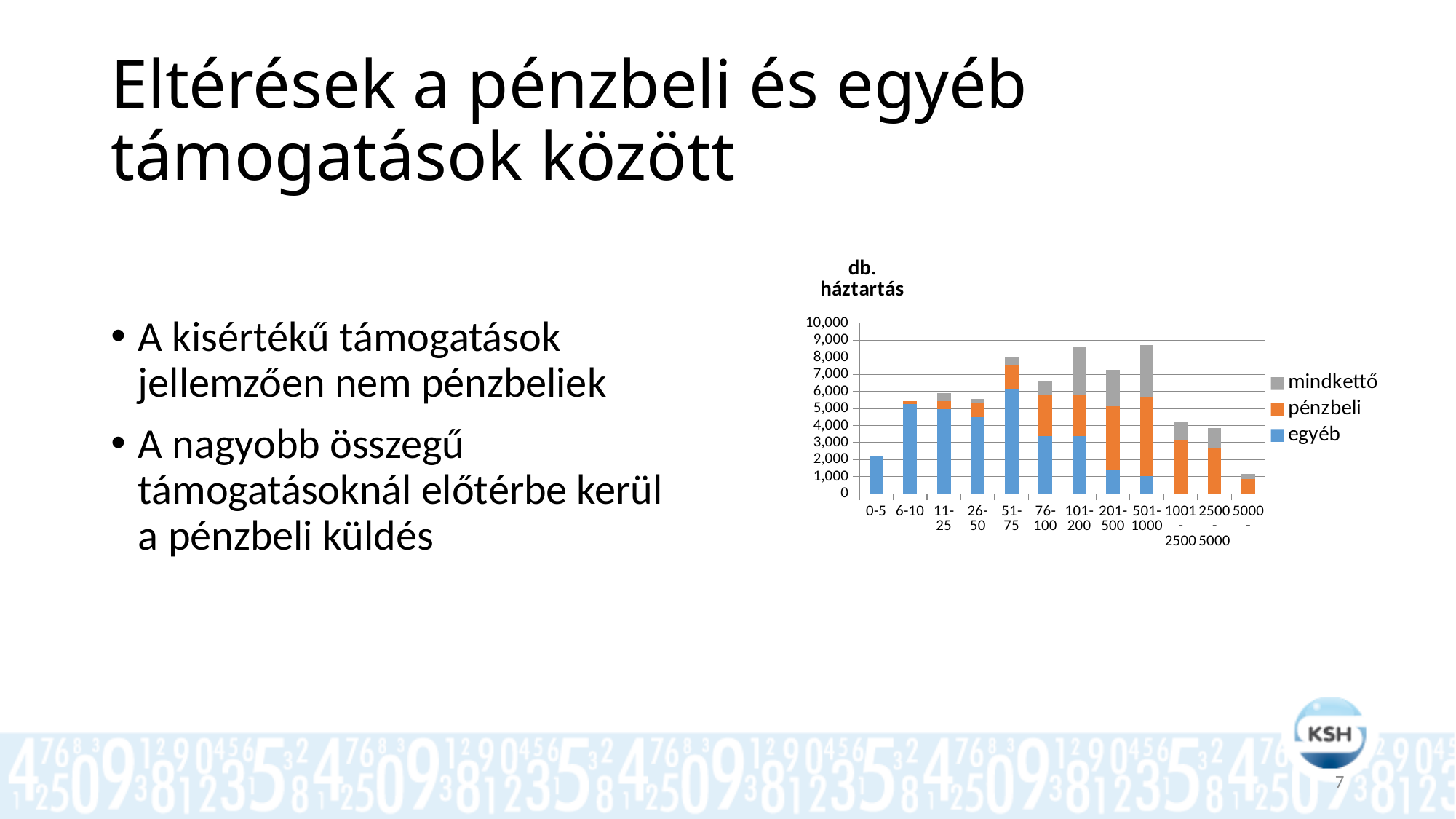
Is the total value for the 0-5 category greater or less than 3,000? less Is the egyéb value for the 6-10 category greater or less than 4,000? greater How many series does the chart legend list? 3 Which category has the lowest total bar height in the chart? 5000- Which series is shown in blue in the chart? egyéb What kind of chart is shown on the slide? stacked bar chart Is the total value for the 1001-2500 category greater or less than 5,000? less Which category has the larger total bar, 0-5 or 6-10? 6-10 What is the title of the chart? db. háztartás How many categories are shown on the x axis of the chart? 12